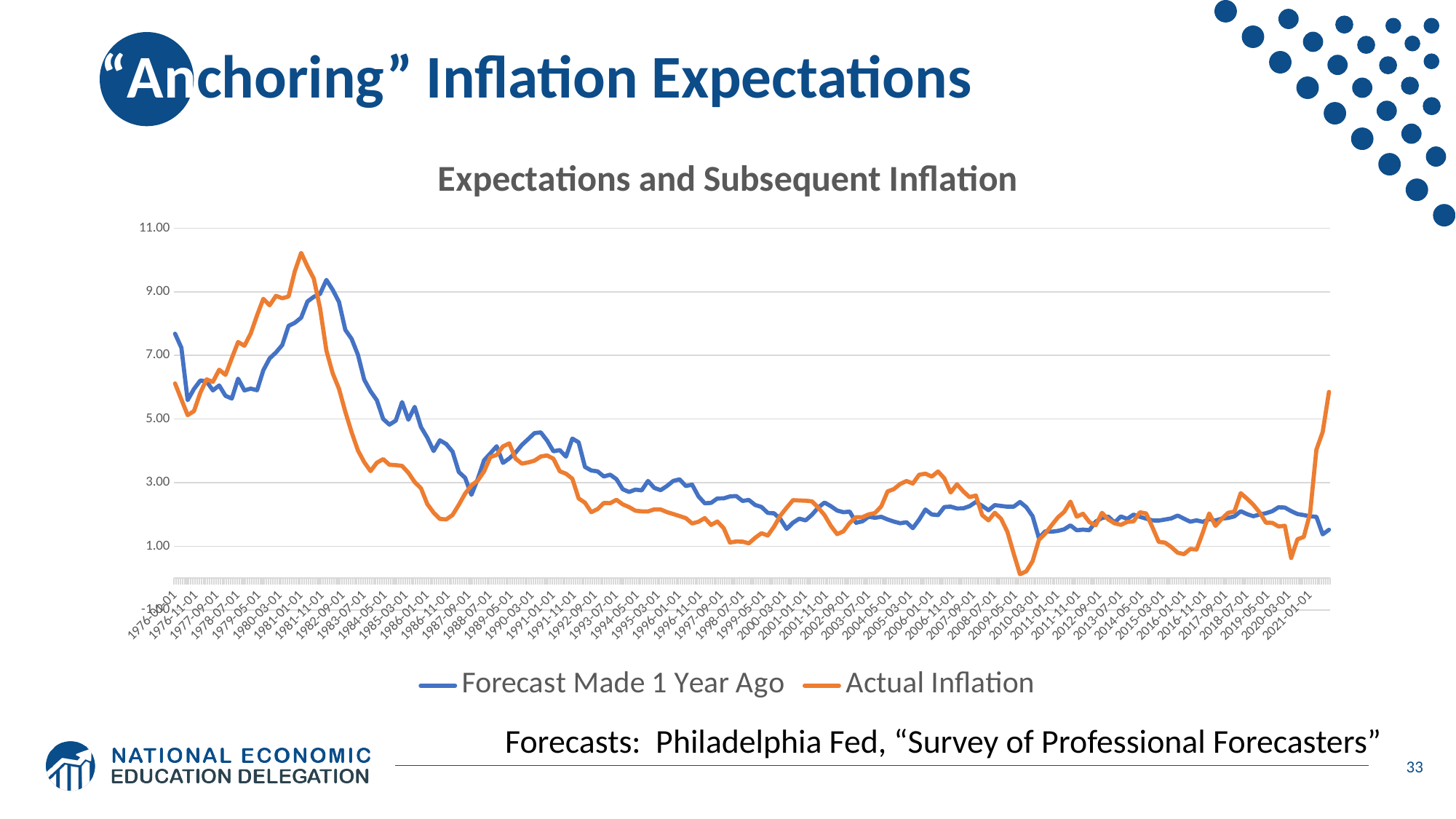
Is the lowest value of Actual Inflation around 2009-2010 greater or less than 1.00? less Is the value of Forecast Made 1 Year Ago around 2015 greater or less than 3.00? less At the far right end of the chart (2021), which series has the higher value, Forecast Made 1 Year Ago or Actual Inflation? Actual Inflation How many series does the chart legend list? 2 Which series reaches the highest peak on the chart? Actual Inflation Is the peak value of Actual Inflation around 1981 greater or less than 9.00? greater What type of chart is shown on the slide? Line chart What is the title of the chart? Expectations and Subsequent Inflation Which colour is used for the Actual Inflation series? Orange Around 2009-2010, which series has the higher value, Forecast Made 1 Year Ago or Actual Inflation? Forecast Made 1 Year Ago From the early 1980s to the late 1990s, does Actual Inflation generally rise or fall? Fall